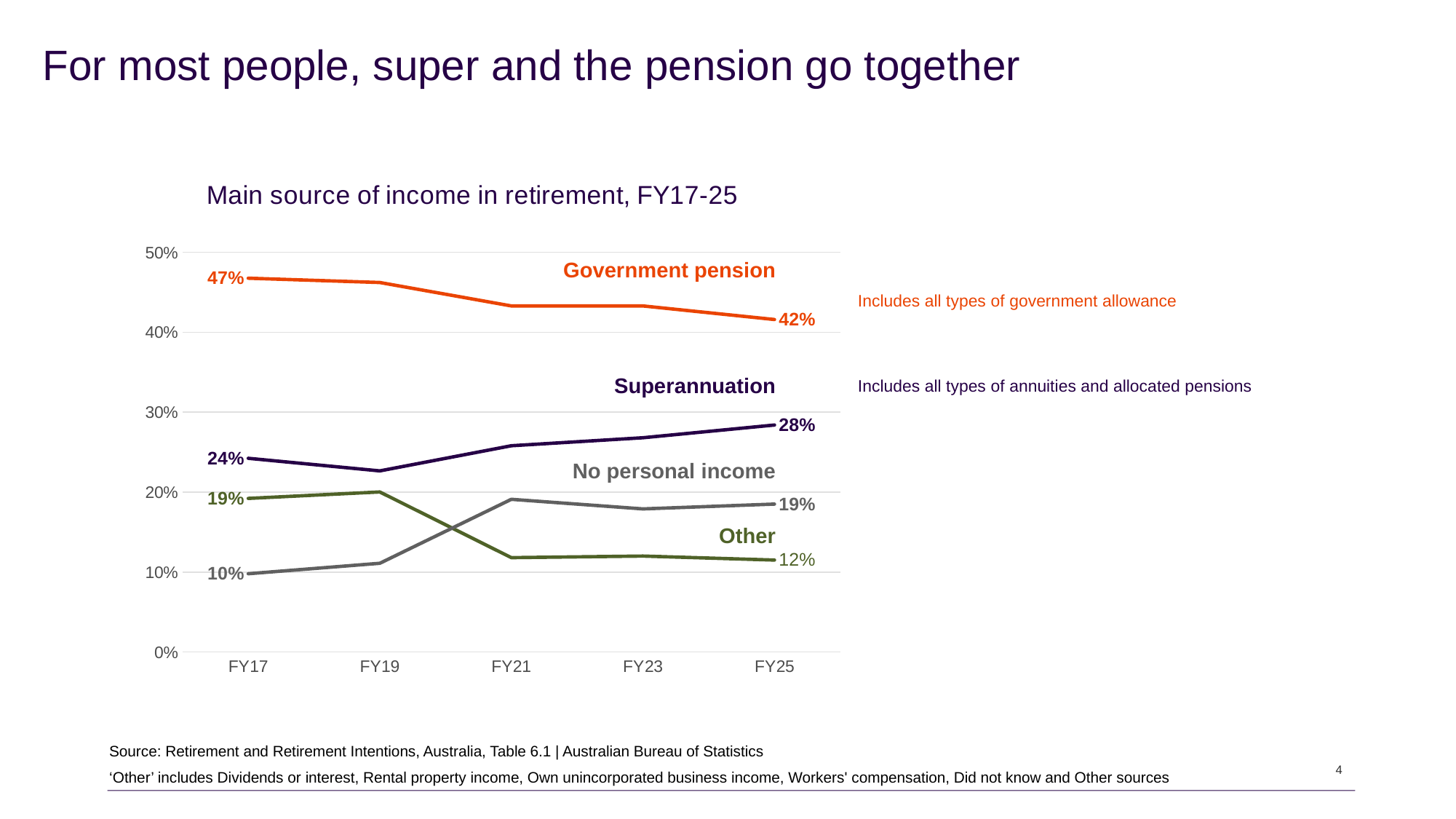
What was the Superannuation value in FY25? 28% What type of chart is shown on the slide? Line chart What was the Government pension value in FY25? 42% Does the Superannuation line rise or fall from FY17 to FY25? Rise How many fiscal years are shown on the x axis? 5 Which source of income had the highest value in FY25? Government pension By how many percentage points did Government pension fall from FY17 to FY25? 5 percentage points Which source of income had the lowest value in FY17? No personal income What was the Other value in FY25? 12% What was the Government pension value in FY17? 47% What was the No personal income value in FY17? 10% What is the title of the chart? Main source of income in retirement, FY17-25